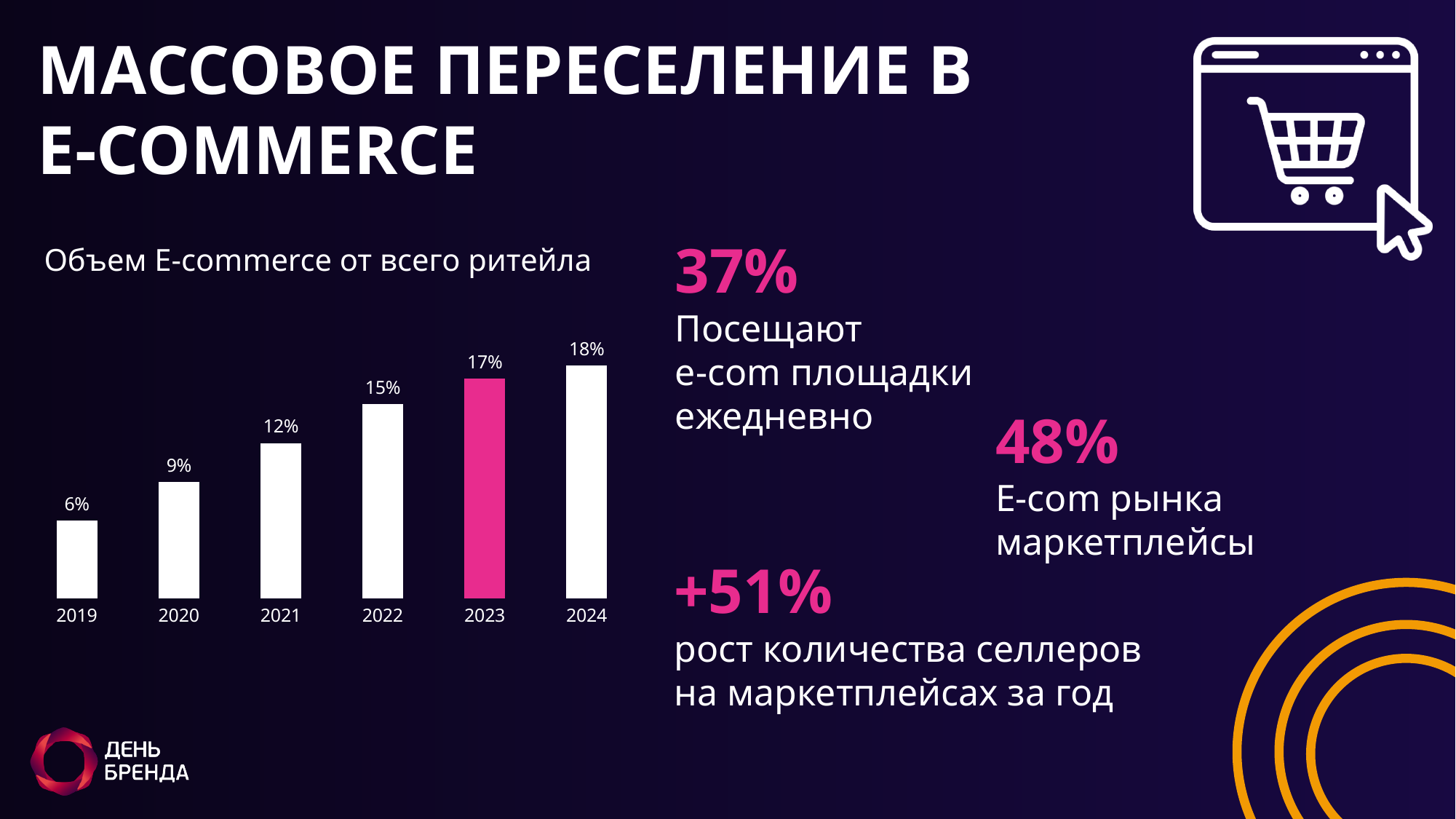
Do the values rise or fall from 2019 to 2024? rise Which year's bar is highlighted in pink in the chart? 2023 What is the difference between the values for 2021 and 2020? 3% How many years are shown in the chart? 6 What is the difference between the values for 2024 and 2019? 12% Which year has the highest value in the chart? 2024 Which is larger, the value for 2020 or the value for 2022? 2022 What is the value for 2022 in the chart? 15% Which year has the lowest value in the chart? 2019 What is the value for 2019 in the chart? 6% What is the value for 2023 in the chart? 17% What kind of chart is shown on the slide? bar chart